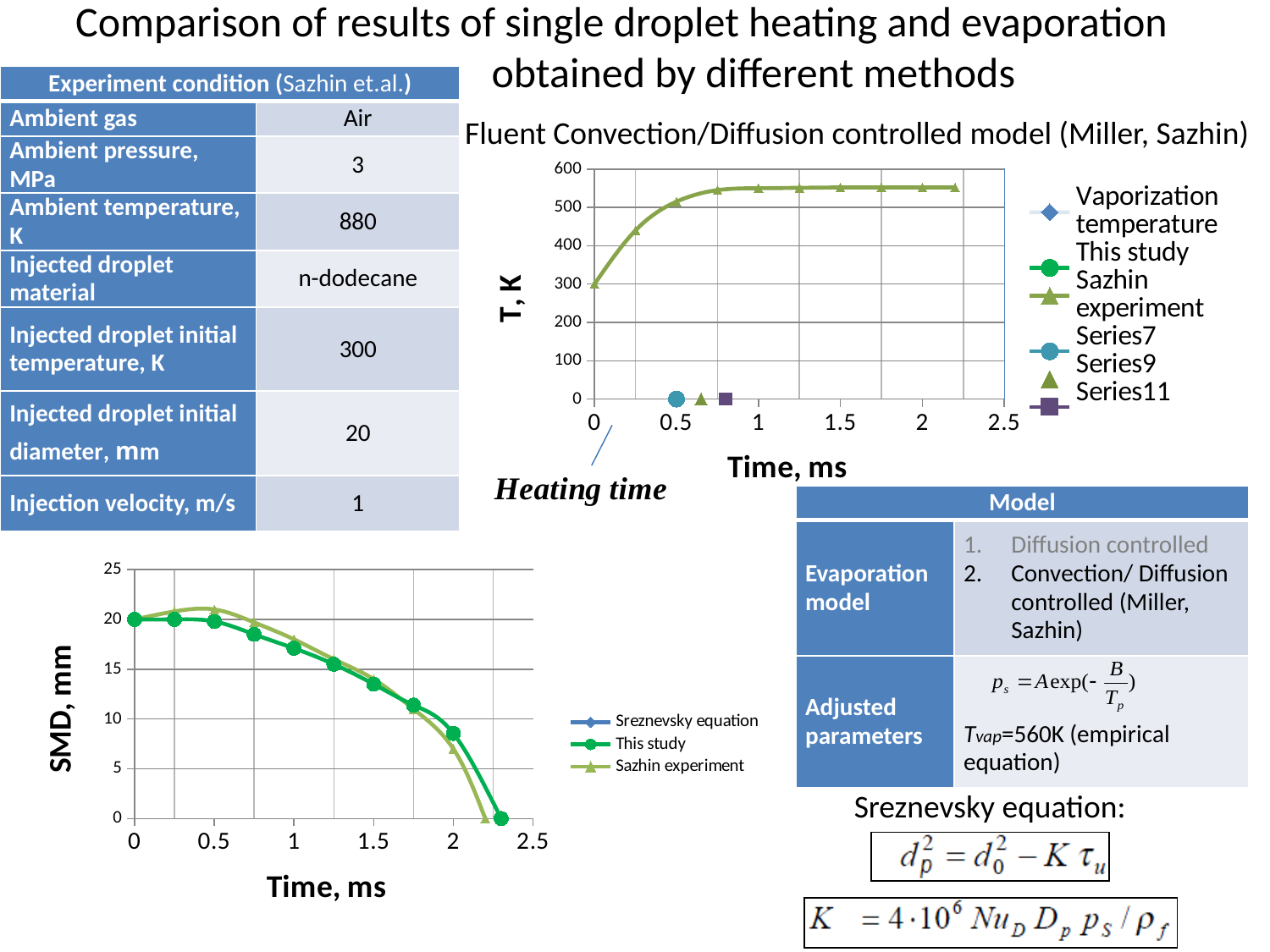
In the bottom-left SMD chart, how many series does the legend list? 3 In the bottom-left SMD chart, is the SMD for This study at 1 ms greater or less than 15? greater In the top-right temperature chart, what kind of chart is it? line chart In the top-right temperature chart, is the temperature at 0.25 ms greater or less than 400? greater In the top-right temperature chart, does the temperature rise or fall as time increases from 0 to 1 ms? rise In the top-right temperature chart, what is the y-axis title? T, K In the top-right temperature chart, is the temperature at 1 ms greater or less than 500? greater In the bottom-left SMD chart, what is the SMD value for This study at time 0 ms? 20 In the bottom-left SMD chart, does the SMD rise or fall as time increases? fall In the bottom-left SMD chart, what kind of chart is it? line chart In the top-right temperature chart, how many entries does the legend list? 6